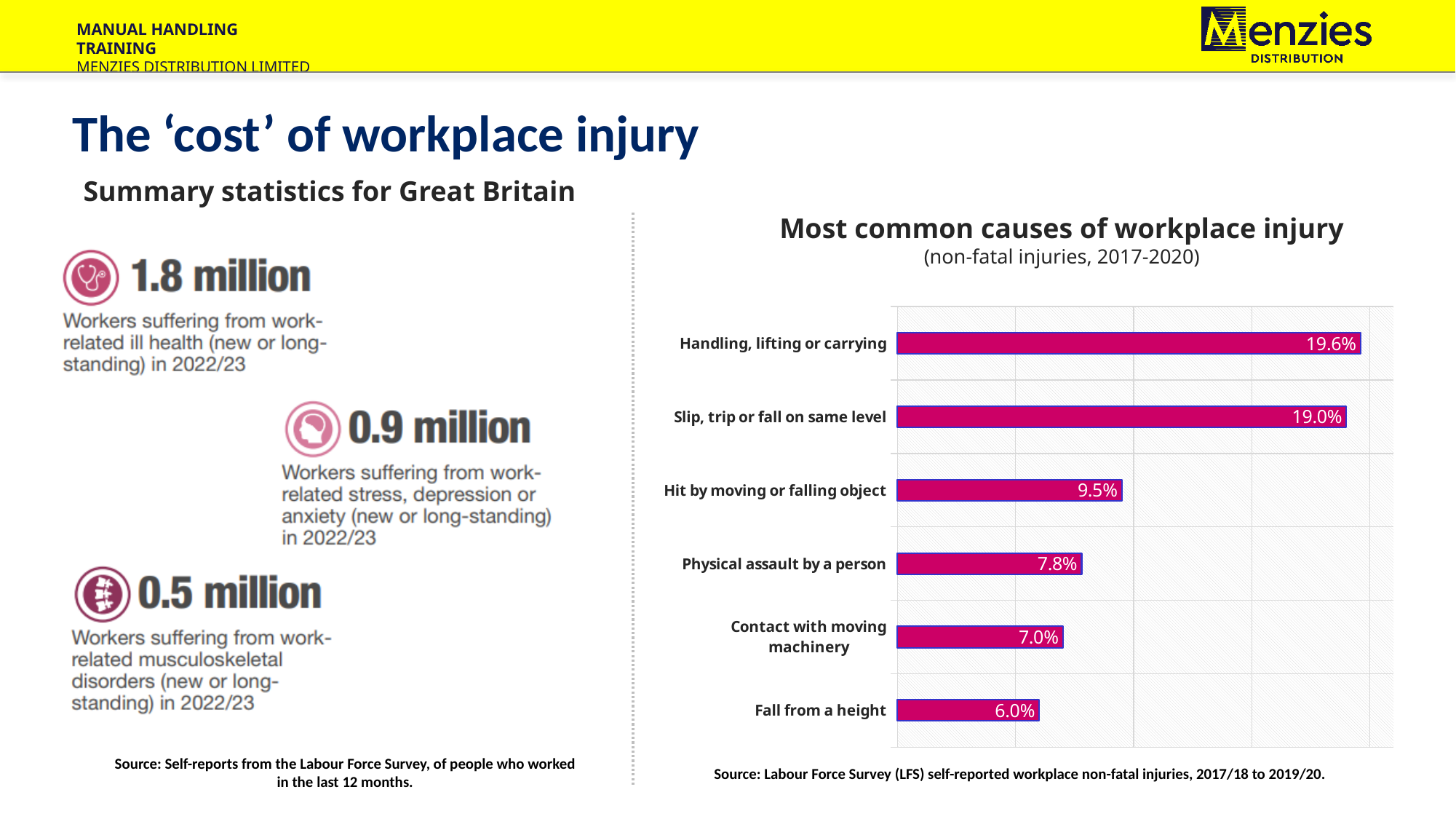
Which is larger, the value for Hit by moving or falling object or the value for Physical assault by a person? Hit by moving or falling object What is the difference between the values for Handling, lifting or carrying and Slip, trip or fall on same level? 0.6% How many causes of workplace injury are shown in the chart? 6 Which cause of workplace injury has the lowest value? Fall from a height What is the value for Handling, lifting or carrying? 19.6% What kind of chart is used to show the most common causes of workplace injury? Bar chart What is the value for Physical assault by a person? 7.8% Which cause of workplace injury has the highest value? Handling, lifting or carrying What is the value for Hit by moving or falling object? 9.5% What is the value for Slip, trip or fall on same level? 19.0% What is the value for Contact with moving machinery? 7.0% What is the value for Fall from a height? 6.0%